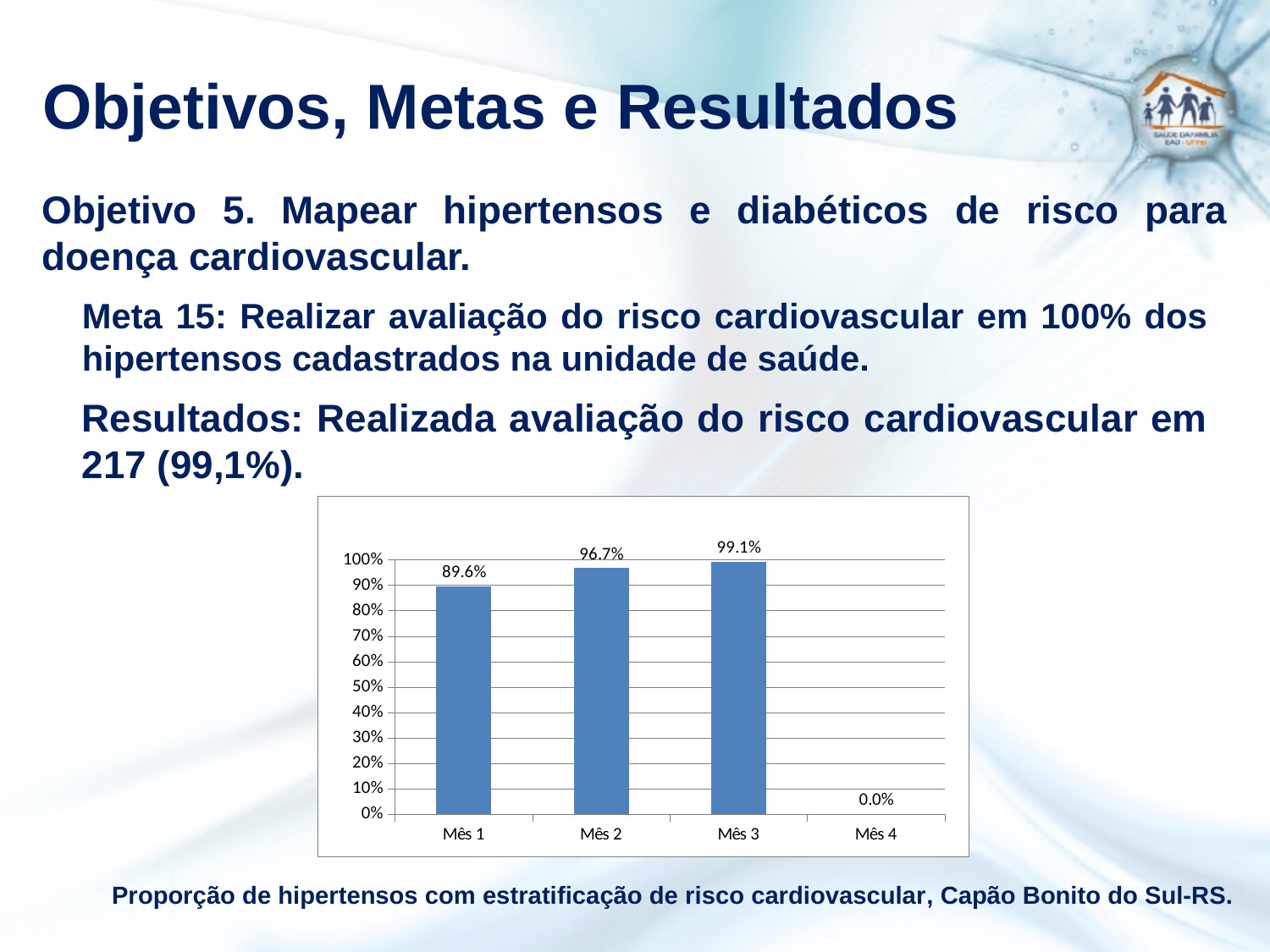
Which is larger, the value for Mês 2 or the value for Mês 1? Mês 2 What is the difference between the values for Mês 3 and Mês 1? 9.5% What is the value for Mês 4? 0.0% Which month has the highest value? Mês 3 What is the value for Mês 3? 99.1% Is the value for Mês 1 greater or less than 80%? greater Which month has the lowest value? Mês 4 What is the value for Mês 2? 96.7% Do the values rise or fall from Mês 1 to Mês 3? rise What kind of chart is shown on the slide? bar chart What is the value for Mês 1? 89.6% How many months are shown on the x axis? 4